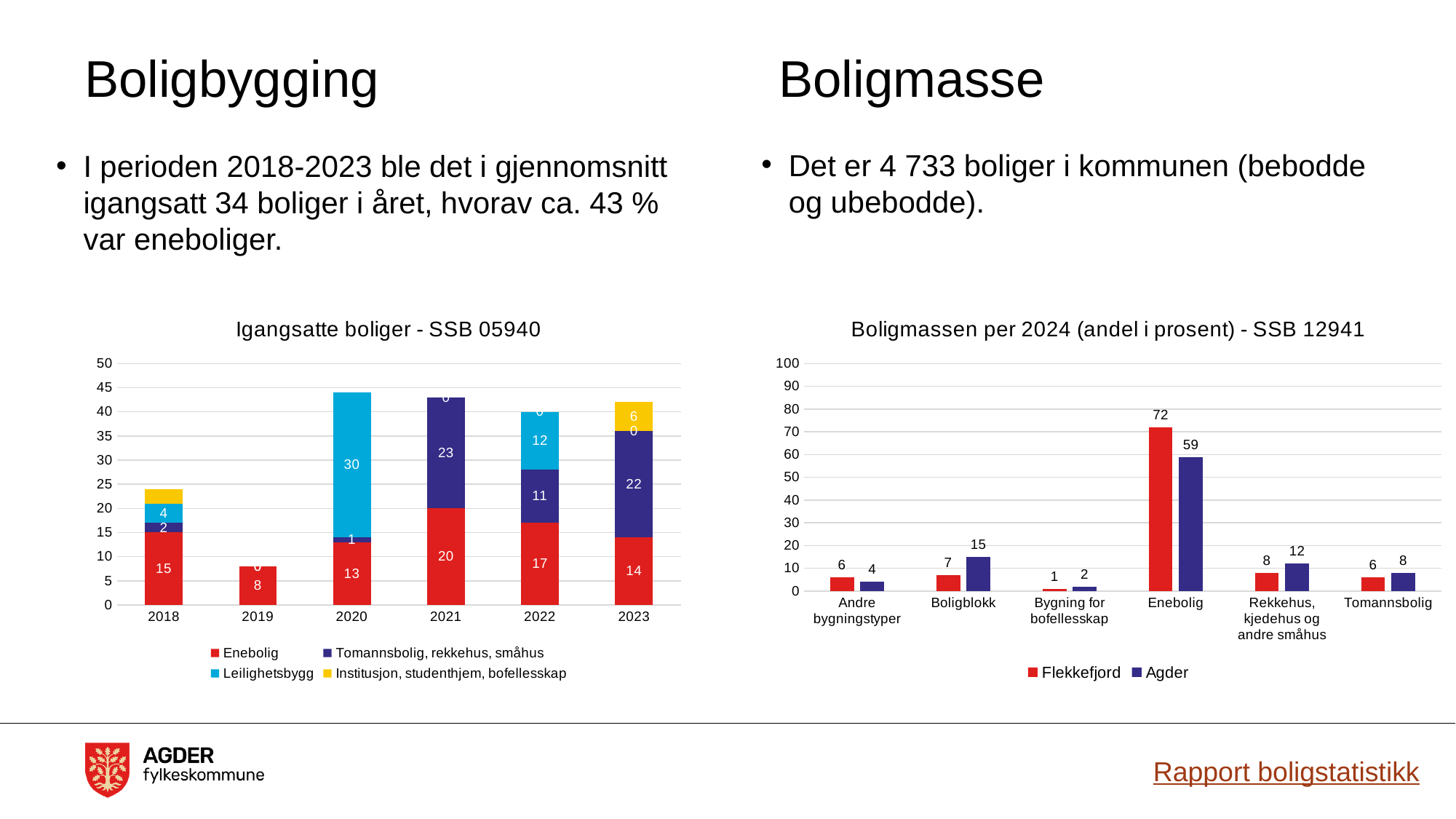
In the chart titled "Boligmassen per 2024 (andel i prosent) - SSB 12941", what is the difference between the Flekkefjord and Agder values for Enebolig? 13 In the chart titled "Boligmassen per 2024 (andel i prosent) - SSB 12941", which category has the highest Agder value? Enebolig In the chart titled "Boligmassen per 2024 (andel i prosent) - SSB 12941", which is larger for Rekkehus, kjedehus og andre småhus: Flekkefjord or Agder? Agder In the chart titled "Igangsatte boliger - SSB 05940", what kind of chart is shown? Stacked bar chart In the chart titled "Igangsatte boliger - SSB 05940", how many series does the legend list? 4 In the chart titled "Igangsatte boliger - SSB 05940", which year has the lowest Enebolig value? 2019 In the chart titled "Boligmassen per 2024 (andel i prosent) - SSB 12941", how many categories are shown on the x axis? 6 In the chart titled "Igangsatte boliger - SSB 05940", what is the Enebolig value for 2020? 13 In the chart titled "Igangsatte boliger - SSB 05940", what is the total height of the stacked bar for 2021? 43 In the chart titled "Boligmassen per 2024 (andel i prosent) - SSB 12941", what is the Agder value for Boligblokk? 15 In the chart titled "Igangsatte boliger - SSB 05940", what is the Leilighetsbygg value for 2022? 12 In the chart titled "Boligmassen per 2024 (andel i prosent) - SSB 12941", what is the Flekkefjord value for Enebolig? 72